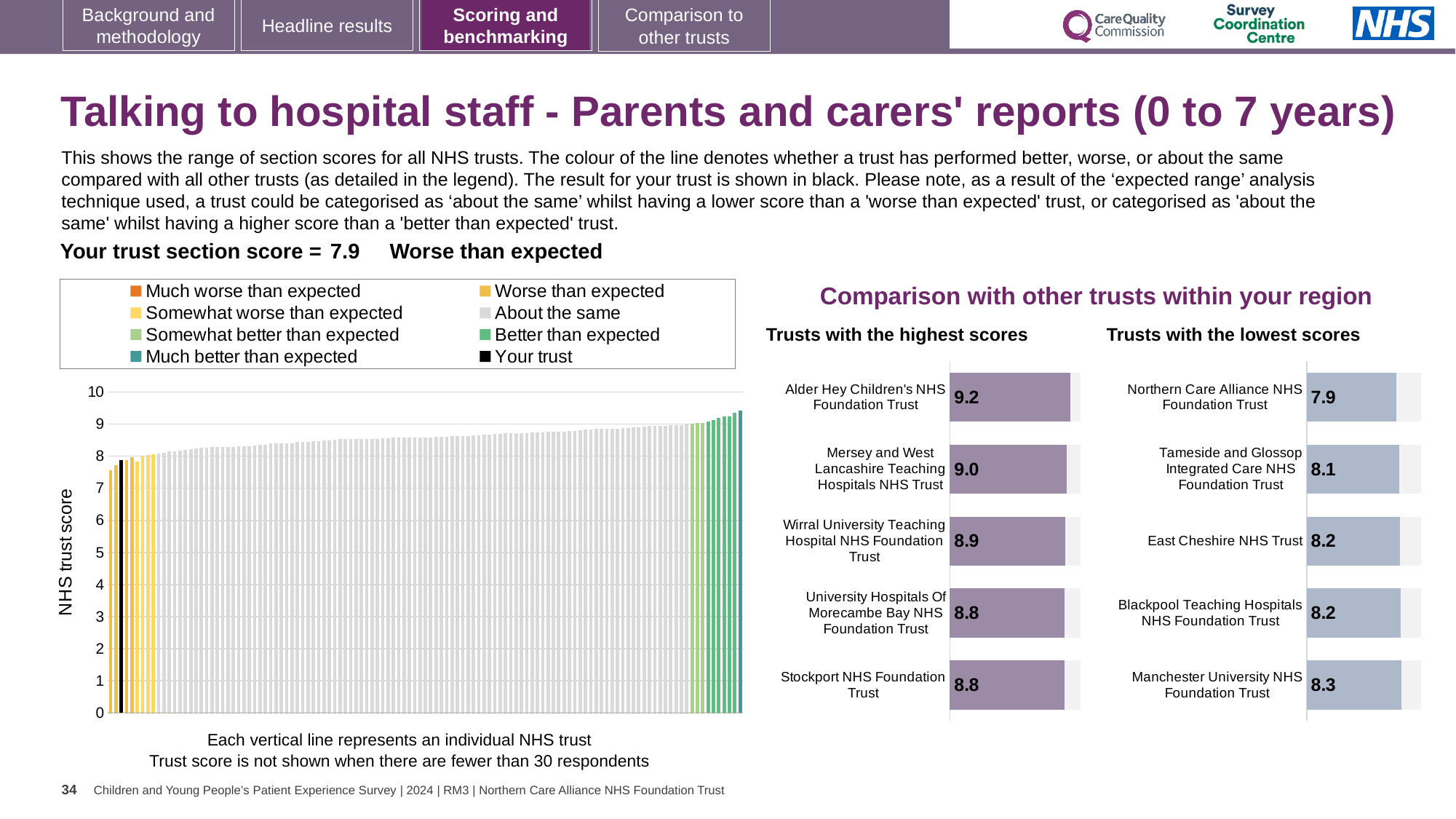
In the 'Trusts with the lowest scores' chart, which trust has the lowest score? Northern Care Alliance NHS Foundation Trust In the 'Trusts with the lowest scores' chart, how much higher is Manchester University NHS Foundation Trust's score than Northern Care Alliance NHS Foundation Trust's score? 0.4 In the 'Trusts with the lowest scores' chart, what is the score for Manchester University NHS Foundation Trust? 8.3 In the 'Trusts with the lowest scores' chart, what is the score for Northern Care Alliance NHS Foundation Trust? 7.9 What kind of chart is the large 'NHS trust score' chart on the left of the slide? Bar chart In the 'Trusts with the highest scores' chart, what is the score for Alder Hey Children's NHS Foundation Trust? 9.2 In the 'Trusts with the highest scores' chart, which trust has the highest score? Alder Hey Children's NHS Foundation Trust In the 'Trusts with the highest scores' chart, what is the score for Stockport NHS Foundation Trust? 8.8 How many entries does the legend above the 'NHS trust score' chart list? 8 How many trusts are shown in the 'Trusts with the lowest scores' chart? 5 In the 'Trusts with the highest scores' chart, which has the higher score: Wirral University Teaching Hospital NHS Foundation Trust or University Hospitals Of Morecambe Bay NHS Foundation Trust? Wirral University Teaching Hospital NHS Foundation Trust In the 'Trusts with the highest scores' chart, what is the difference between the scores of Alder Hey Children's NHS Foundation Trust and Mersey and West Lancashire Teaching Hospitals NHS Trust? 0.2